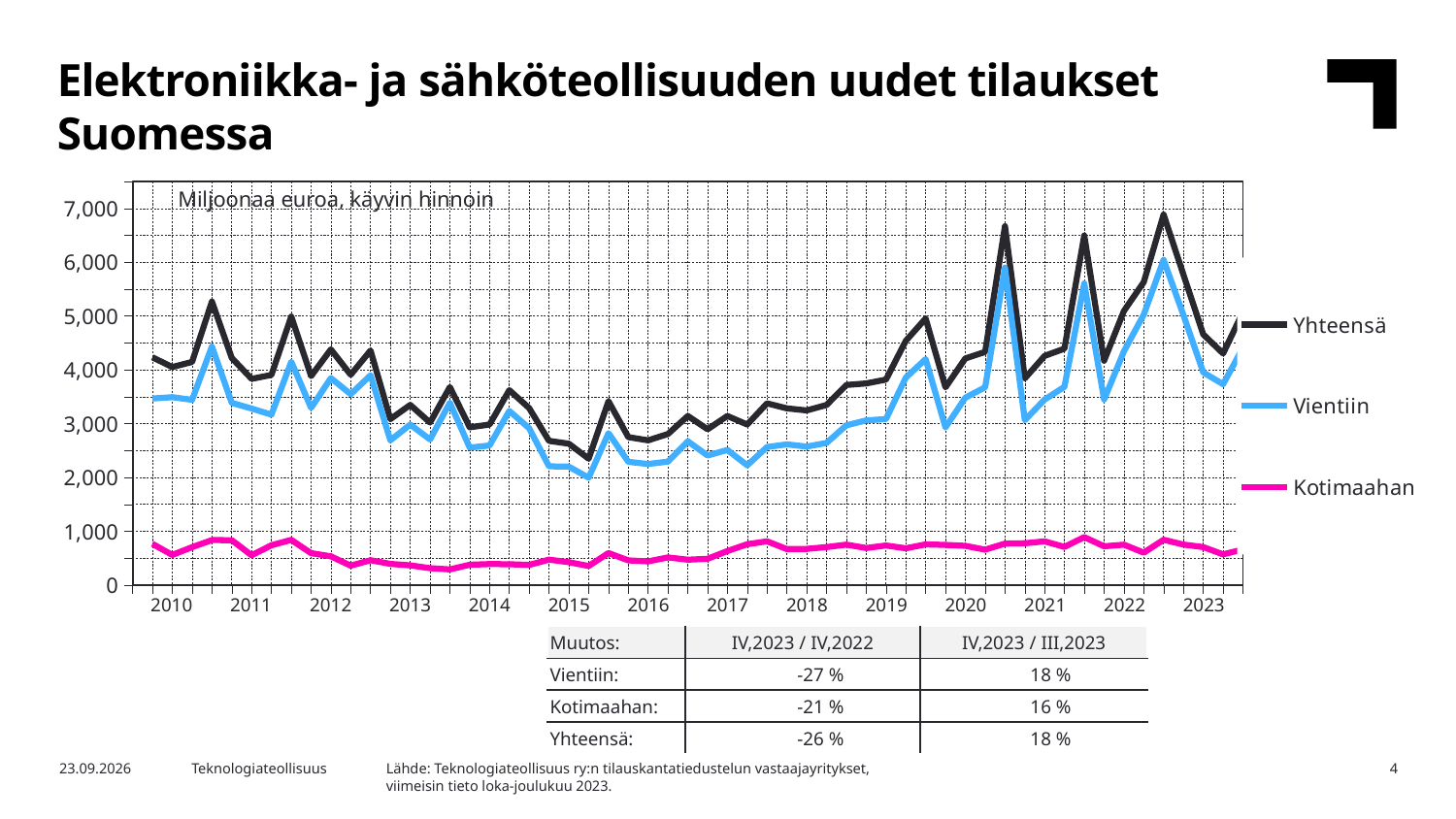
Is the value for Yhteensä in 2013 greater or less than 4,000? less How many year labels are shown on the x axis? 14 Which series has the highest values across the whole chart? Yhteensä Does the Yhteensä line overall rise or fall from 2015 to 2022? rise What are the three series named in the chart legend? Yhteensä, Vientiin, Kotimaahan How many series does the chart legend list? 3 What unit label is shown at the top of the chart? Miljoonaa euroa, käyvin hinnoin Which is larger in 2020, the value for Vientiin or the value for Kotimaahan? Vientiin Which series has the lowest values across the whole chart? Kotimaahan What kind of chart is shown on the slide? line chart Is the value for Kotimaahan in 2015 greater or less than 1,000? less Is the peak value for Yhteensä in 2022 greater or less than 6,000? greater